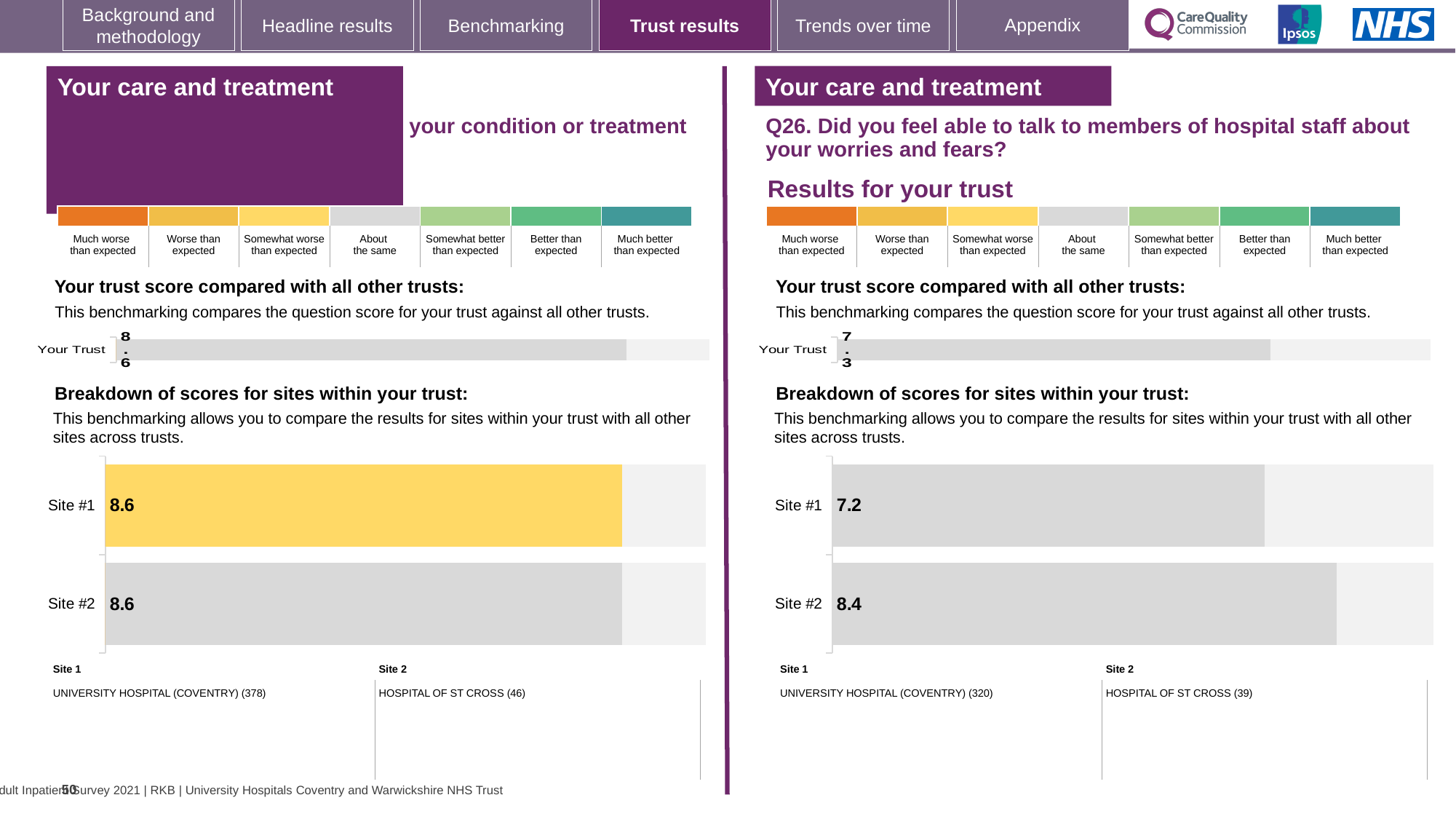
On the Q26 panel's 'Breakdown of scores for sites within your trust' chart, what is the score for Site #2? 8.4 On the Q26 panel's 'Breakdown of scores for sites within your trust' chart, what is the score for Site #1? 7.2 On the left panel's 'Breakdown of scores for sites within your trust' chart, what is the score for Site #1? 8.6 How many sites are shown on the left panel's 'Breakdown of scores for sites within your trust' chart? 2 On the left panel's 'Your trust score compared with all other trusts' chart, what is the score for Your Trust? 8.6 On the Q26 panel's site breakdown chart, what is the difference between the Site #2 and Site #1 scores? 1.2 On the Q26 panel's site breakdown chart, which site has the higher score? Site #2 On the Q26 panel's site breakdown chart, which site has the lower score? Site #1 On the left panel's 'Breakdown of scores for sites within your trust' chart, what is the score for Site #2? 8.6 On the Q26 panel's 'Your trust score compared with all other trusts' chart, what is the score for Your Trust? 7.3 What type of chart is used for the 'Breakdown of scores for sites within your trust' on the Q26 panel? Bar chart On the left panel's site breakdown chart, what colour is the bar for Site #1? Yellow